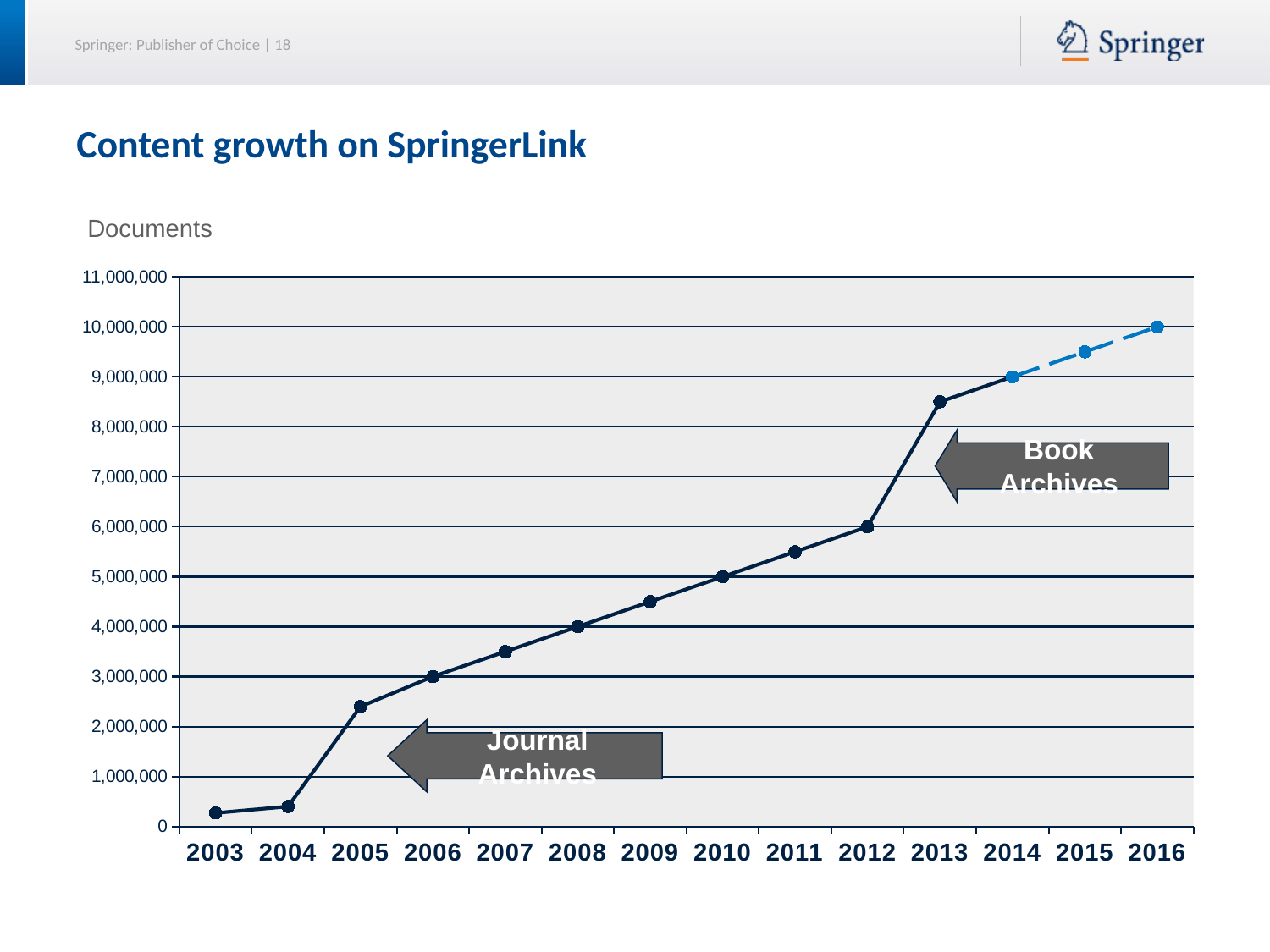
Is the value for 2013 greater or less than 8,000,000? greater Which year has the highest value? 2016 Is the value for 2005 greater or less than 3,000,000? less Do the values rise or fall from 2003 to 2016? rise What is the value for 2006? 3,000,000 What kind of chart is shown on the slide? line chart What is the value for 2010? 5,000,000 Which year has the lowest value? 2003 What is the value for 2016? 10,000,000 What is the value for 2014? 9,000,000 How many years are plotted on the x axis? 14 What is the difference between the values for 2016 and 2012? 4,000,000